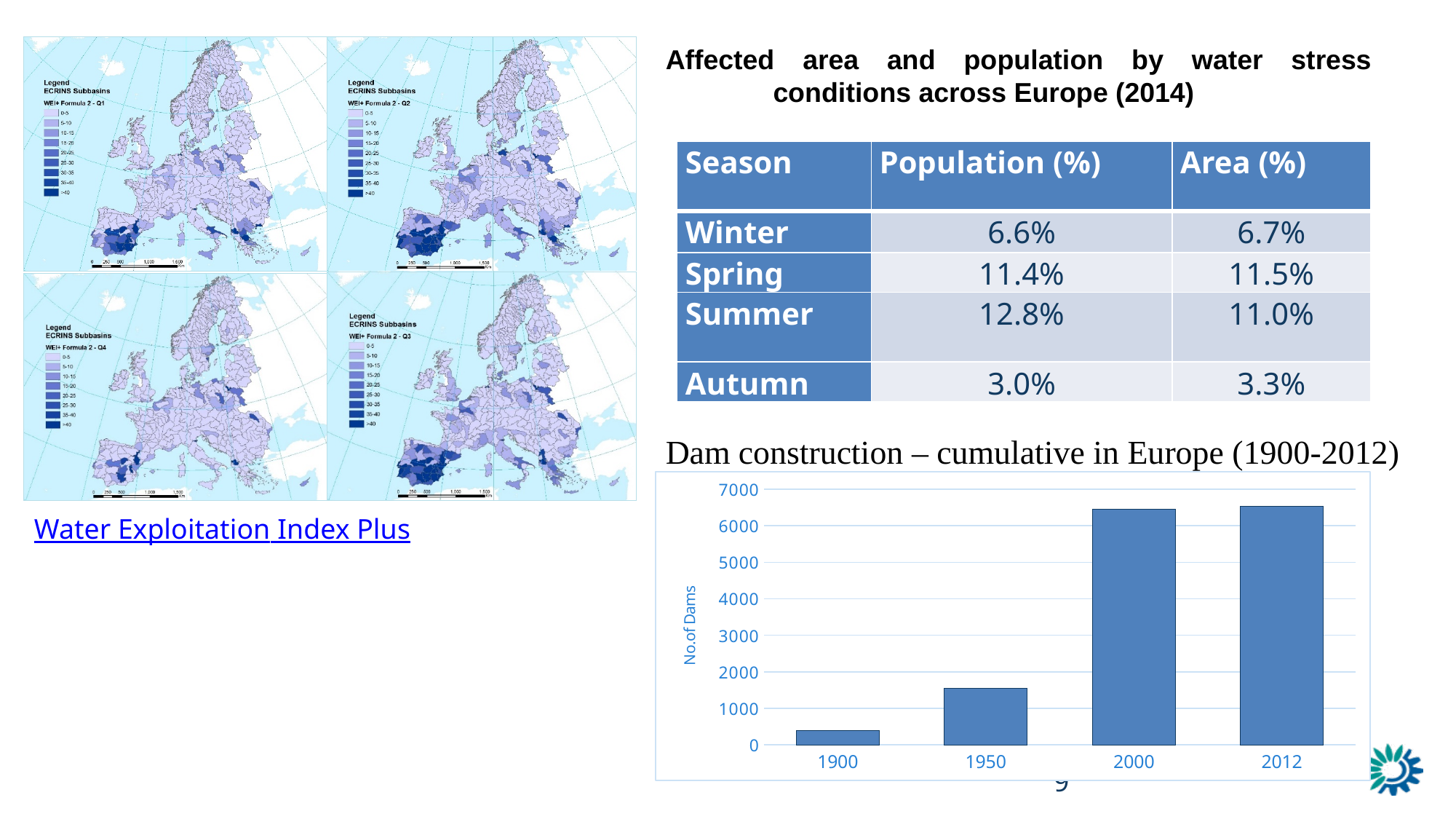
In the 'Dam construction – cumulative in Europe (1900-2012)' chart, which has more dams, 1950 or 2000? 2000 In the 'Dam construction – cumulative in Europe (1900-2012)' chart, is the value for 1900 greater or less than 1000? less What is the label on the vertical axis of the 'Dam construction – cumulative in Europe (1900-2012)' chart? No.of Dams In the 'Dam construction – cumulative in Europe (1900-2012)' chart, which has more dams, 1900 or 1950? 1950 In the 'Dam construction – cumulative in Europe (1900-2012)' chart, is the value for 2012 greater or less than 7000? less In the 'Dam construction – cumulative in Europe (1900-2012)' chart, is the value for 1950 greater or less than 2000? less How many bars are shown in the 'Dam construction – cumulative in Europe (1900-2012)' chart? 4 In the 'Dam construction – cumulative in Europe (1900-2012)' chart, do the values rise or fall from 1900 to 2012? rise In the 'Dam construction – cumulative in Europe (1900-2012)' chart, which year has the lowest number of dams? 1900 What kind of chart is the 'Dam construction – cumulative in Europe (1900-2012)' chart? bar chart